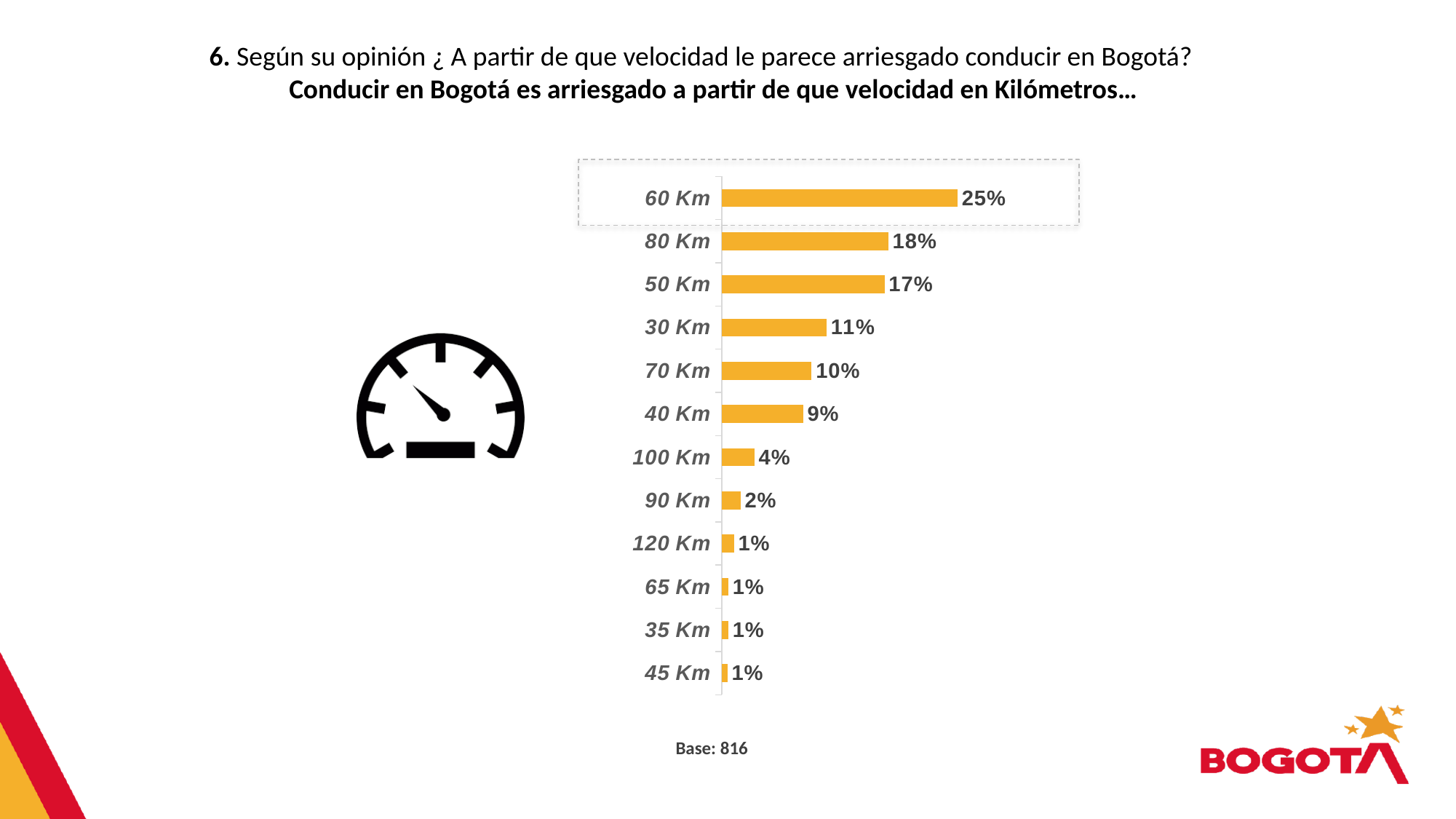
What is the base (number of respondents) stated below the chart? 816 Which has a larger value, 70 Km or 40 Km? 70 Km What is the value shown for 30 Km? 11% Which has a larger value, 100 Km or 90 Km? 100 Km How many speed categories are shown in the chart? 12 Which speed category has the highest percentage? 60 Km What percentage of respondents said driving in Bogotá is risky from 60 Km? 25% What is the value shown for 100 Km? 4% What is the value shown for 80 Km? 18% What kind of chart is shown on the slide? Bar chart What is the difference between the values for 50 Km and 40 Km? 8% What is the difference between the values for 60 Km and 80 Km? 7%